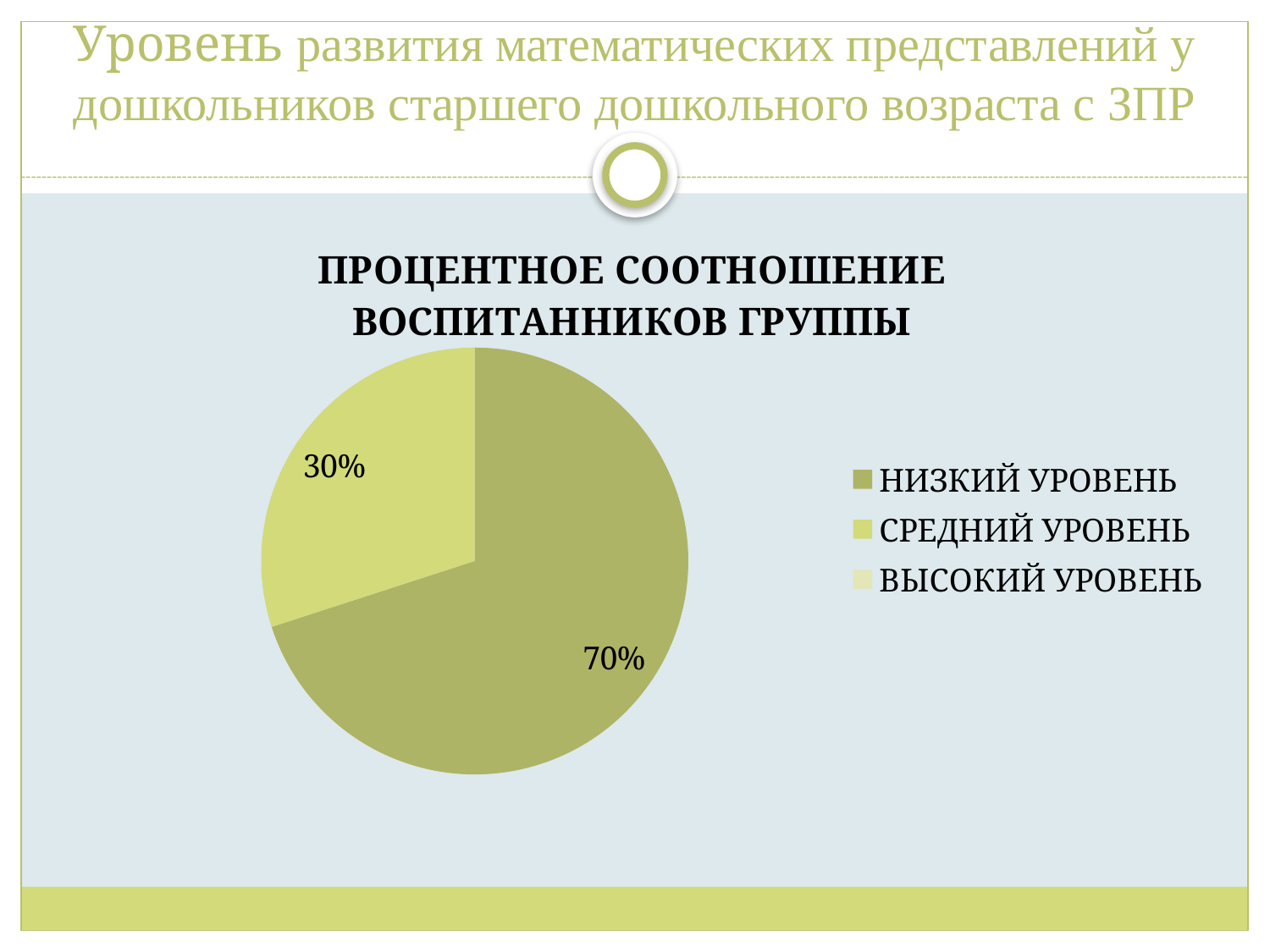
What type of chart is shown on the slide? pie chart What is the combined share of НИЗКИЙ УРОВЕНЬ and СРЕДНИЙ УРОВЕНЬ? 100% What is the difference in percentage points between НИЗКИЙ УРОВЕНЬ and СРЕДНИЙ УРОВЕНЬ? 40 Which legend entry has no visible slice in the pie? ВЫСОКИЙ УРОВЕНЬ How many entries does the legend list? 3 What is the title of the chart? ПРОЦЕНТНОЕ СООТНОШЕНИЕ ВОСПИТАННИКОВ ГРУППЫ Which level has the largest share of the pie? НИЗКИЙ УРОВЕНЬ How many slices with data labels are visible in the pie? 2 What percentage of the group is at НИЗКИЙ УРОВЕНЬ? 70% Which is larger: the share for НИЗКИЙ УРОВЕНЬ or the share for СРЕДНИЙ УРОВЕНЬ? НИЗКИЙ УРОВЕНЬ What percentage of the group is at СРЕДНИЙ УРОВЕНЬ? 30%